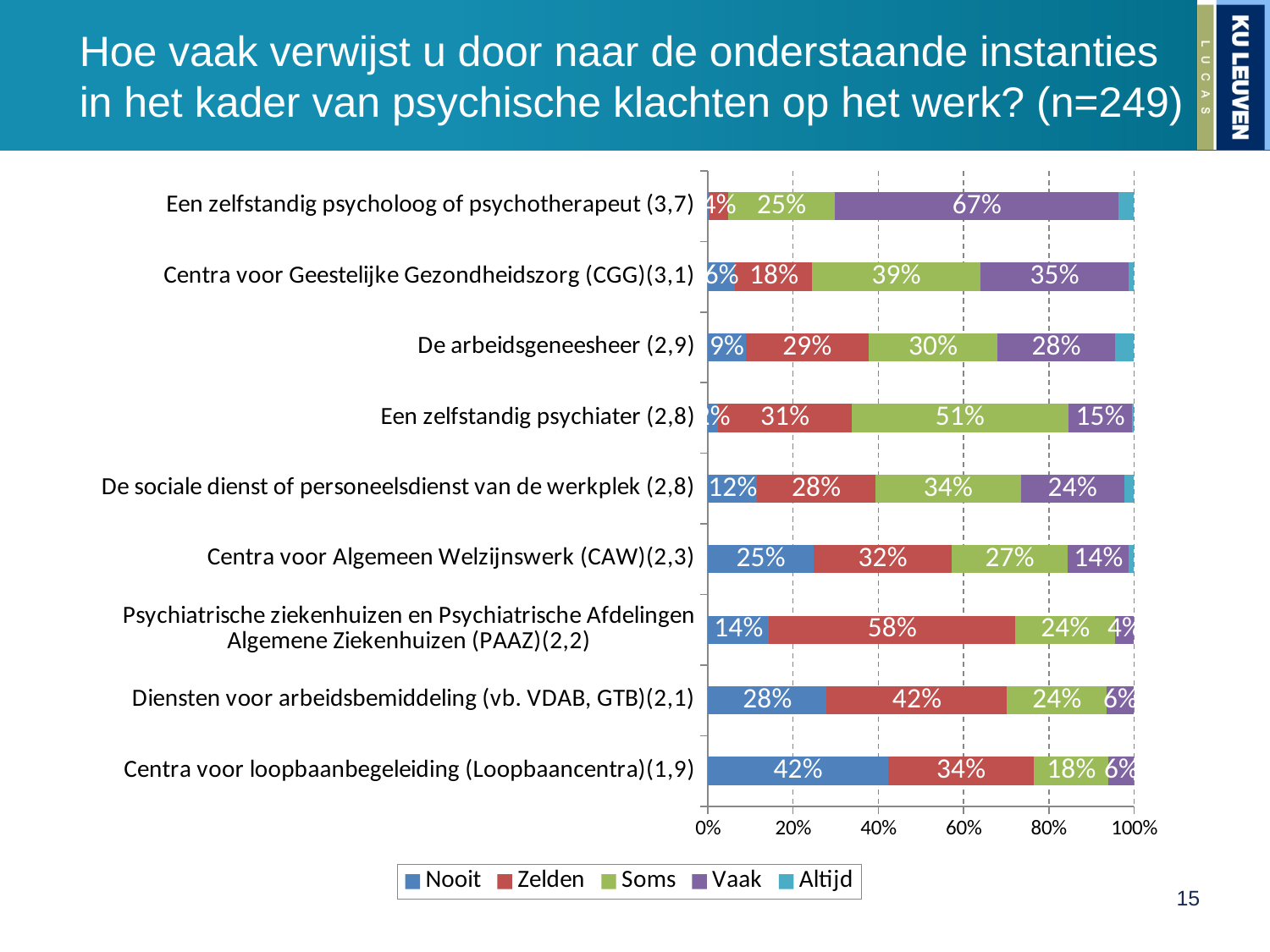
Which legend entry is shown in red? Zelden What is the difference between the 'Zelden' value for 'Diensten voor arbeidsbemiddeling (vb. VDAB, GTB)(2,1)' and the 'Zelden' value for 'Centra voor loopbaanbegeleiding (Loopbaancentra)(1,9)'? 8% Which category has the highest 'Vaak' value? Een zelfstandig psycholoog of psychotherapeut (3,7) What is the 'Nooit' value for 'Centra voor loopbaanbegeleiding (Loopbaancentra)(1,9)'? 42% What is the 'Zelden' value for 'Psychiatrische ziekenhuizen en Psychiatrische Afdelingen Algemene Ziekenhuizen (PAAZ)(2,2)'? 58% What is the 'Vaak' value for 'Een zelfstandig psycholoog of psychotherapeut (3,7)'? 67% What kind of chart is shown on the slide? bar chart Which is larger: the 'Soms' value for 'Centra voor Geestelijke Gezondheidszorg (CGG)(3,1)' or the 'Soms' value for 'De arbeidsgeneesheer (2,9)'? Centra voor Geestelijke Gezondheidszorg (CGG)(3,1) How many series does the legend list? 5 Which category has the highest 'Nooit' value? Centra voor loopbaanbegeleiding (Loopbaancentra)(1,9) What is the 'Soms' value for 'Een zelfstandig psychiater (2,8)'? 51% How many categories (instanties) are plotted in the chart? 9